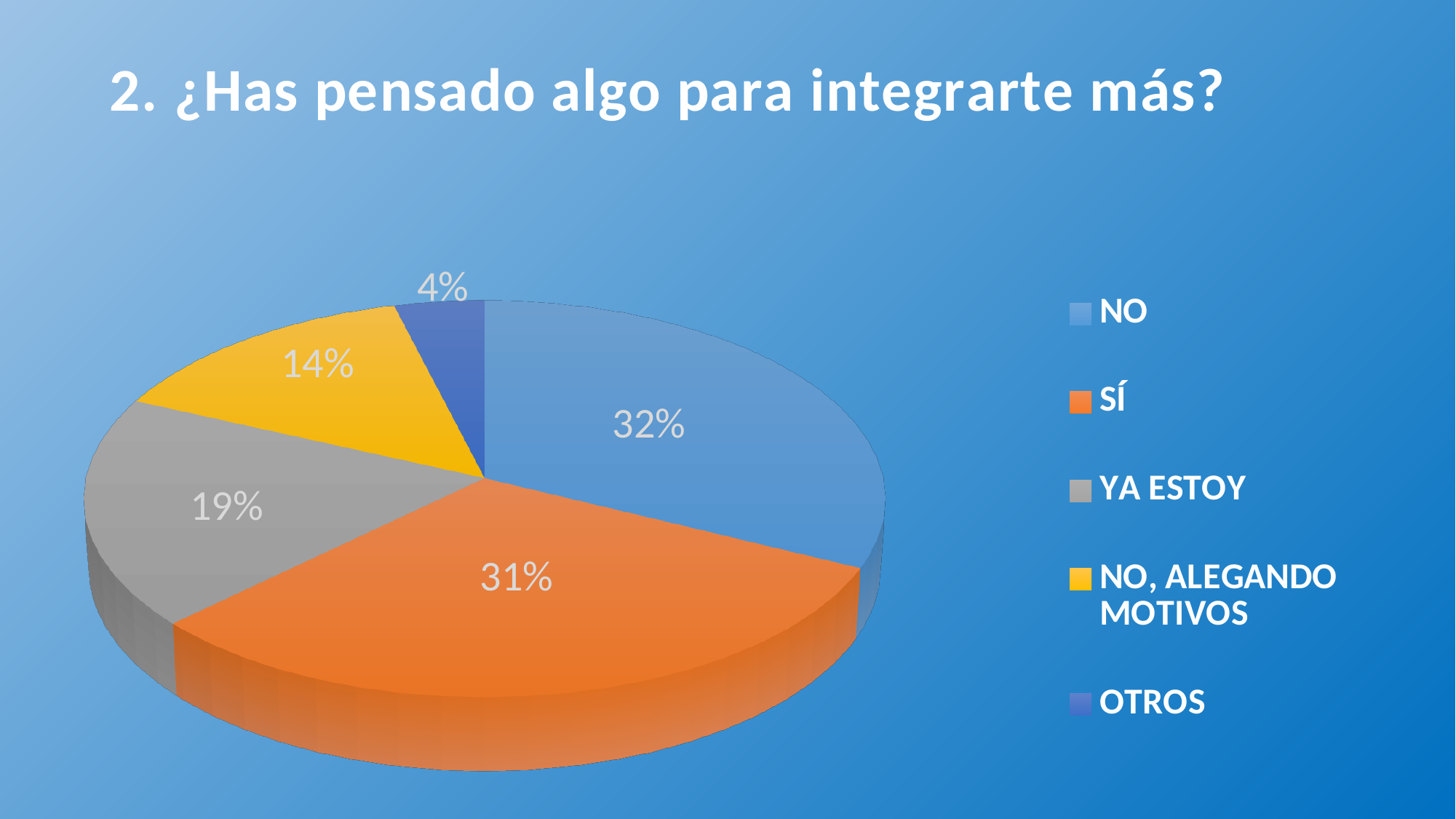
What is the difference in percentage points between YA ESTOY and NO, ALEGANDO MOTIVOS? 5 Which category has the smallest slice of the pie? OTROS What percentage of the pie is labelled NO, ALEGANDO MOTIVOS? 14% What percentage of the pie is labelled NO? 32% What percentage of the pie is labelled YA ESTOY? 19% How many categories does the legend list? 5 Which is larger, the slice for YA ESTOY or the slice for OTROS? YA ESTOY What kind of chart is shown on the slide? pie chart What percentage of the pie is labelled SÍ? 31% What is the title of the chart on the slide? 2. ¿Has pensado algo para integrarte más? What percentage of the pie is labelled OTROS? 4% Which category has the largest slice of the pie? NO